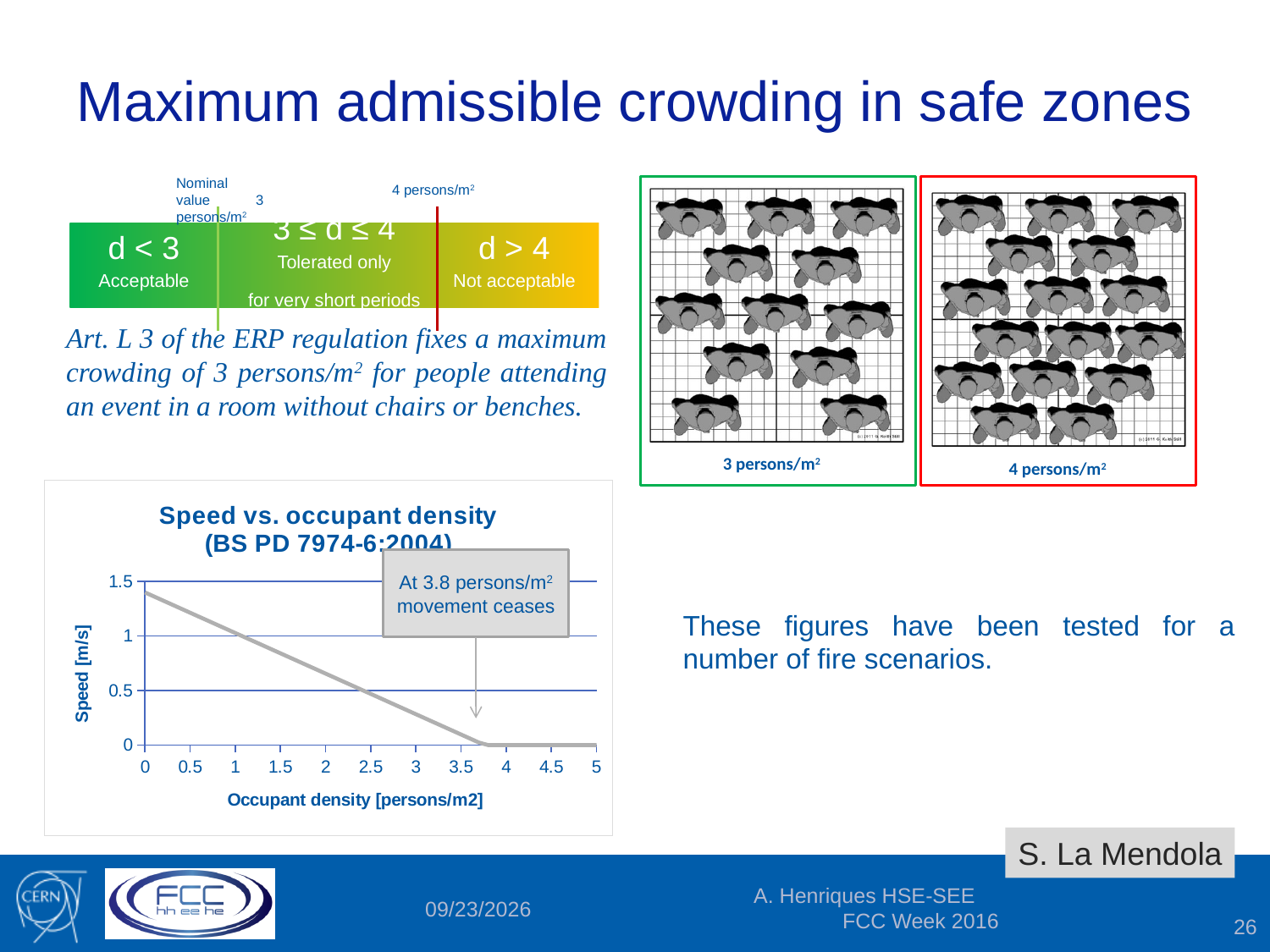
What is the label of the y axis in the 'Speed vs. occupant density' chart? Speed [m/s] In the 'Speed vs. occupant density' chart, is the speed at an occupant density of 3 persons/m2 greater or less than 0.5 m/s? less In the 'Speed vs. occupant density' chart, is the speed at an occupant density of 2 persons/m2 greater or less than 0.5 m/s? greater In the 'Speed vs. occupant density' chart, does speed rise or fall as occupant density increases from 0 to 3.5 persons/m2? fall What is the highest value shown on the x axis of the 'Speed vs. occupant density' chart? 5 What kind of chart is the 'Speed vs. occupant density' chart? line chart In the 'Speed vs. occupant density' chart, is the speed higher at an occupant density of 1 or at 3 persons/m2? 1 According to the annotation on the 'Speed vs. occupant density' chart, at what occupant density does movement cease? 3.8 persons/m² In the 'Speed vs. occupant density' chart, is the speed at an occupant density of 0 greater or less than 1 m/s? greater What is the label of the x axis in the 'Speed vs. occupant density' chart? Occupant density [persons/m2] What is the highest value shown on the y axis of the 'Speed vs. occupant density' chart? 1.5